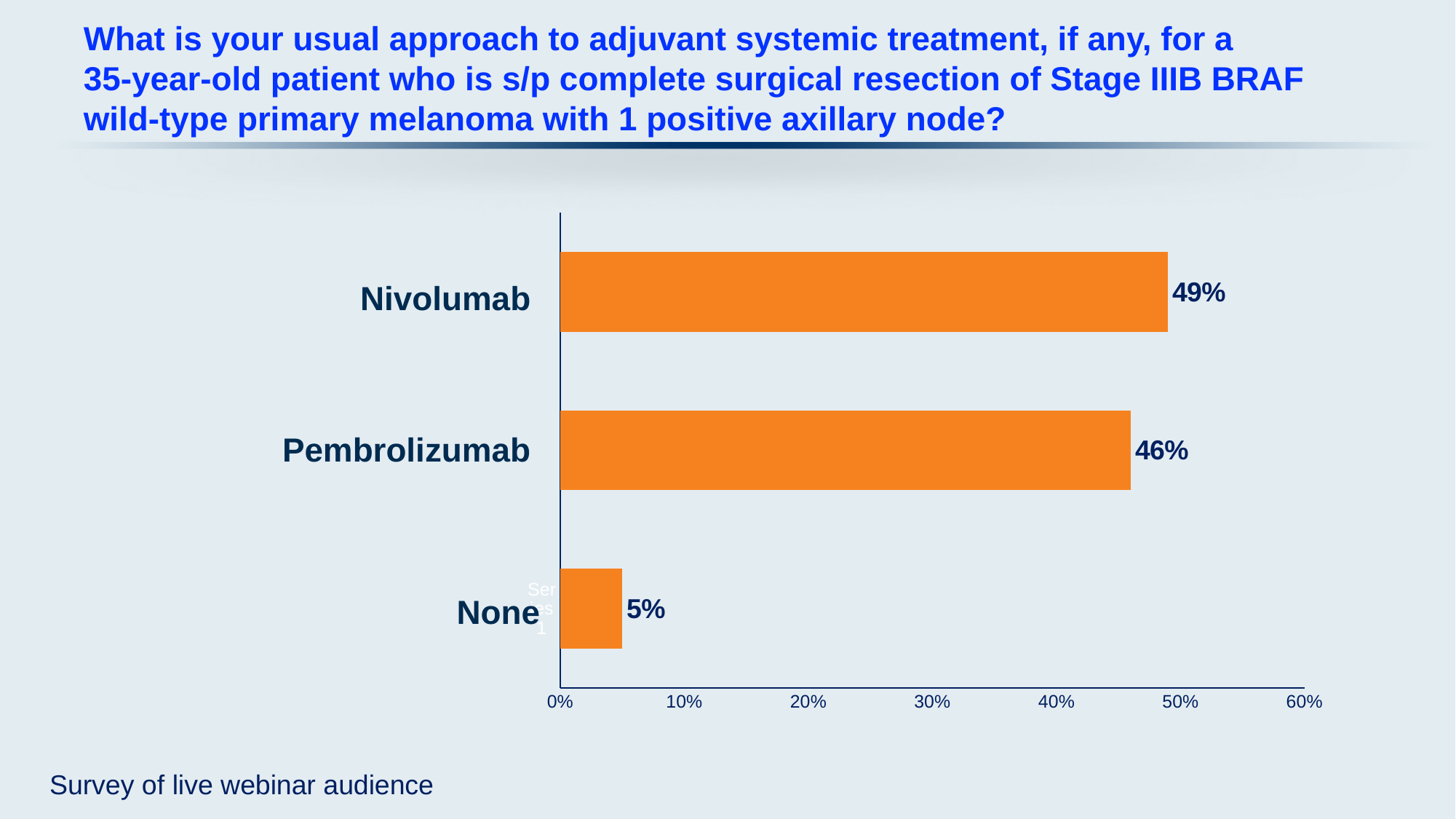
What percentage of respondents chose Pembrolizumab? 46% Which option received the highest percentage of responses? Nivolumab What percentage of respondents chose Nivolumab? 49% What is the maximum value shown on the horizontal axis? 60% How many response options are shown in the chart? 3 What is the difference in percentage points between Nivolumab and Pembrolizumab? 3 Which option received the lowest percentage of responses? None What kind of chart is shown on the slide? Bar chart What percentage of respondents chose None? 5% Which received a larger share of responses, Pembrolizumab or None? Pembrolizumab What is the difference in percentage points between Pembrolizumab and None? 41 Is the value for Pembrolizumab greater or less than 50%? less